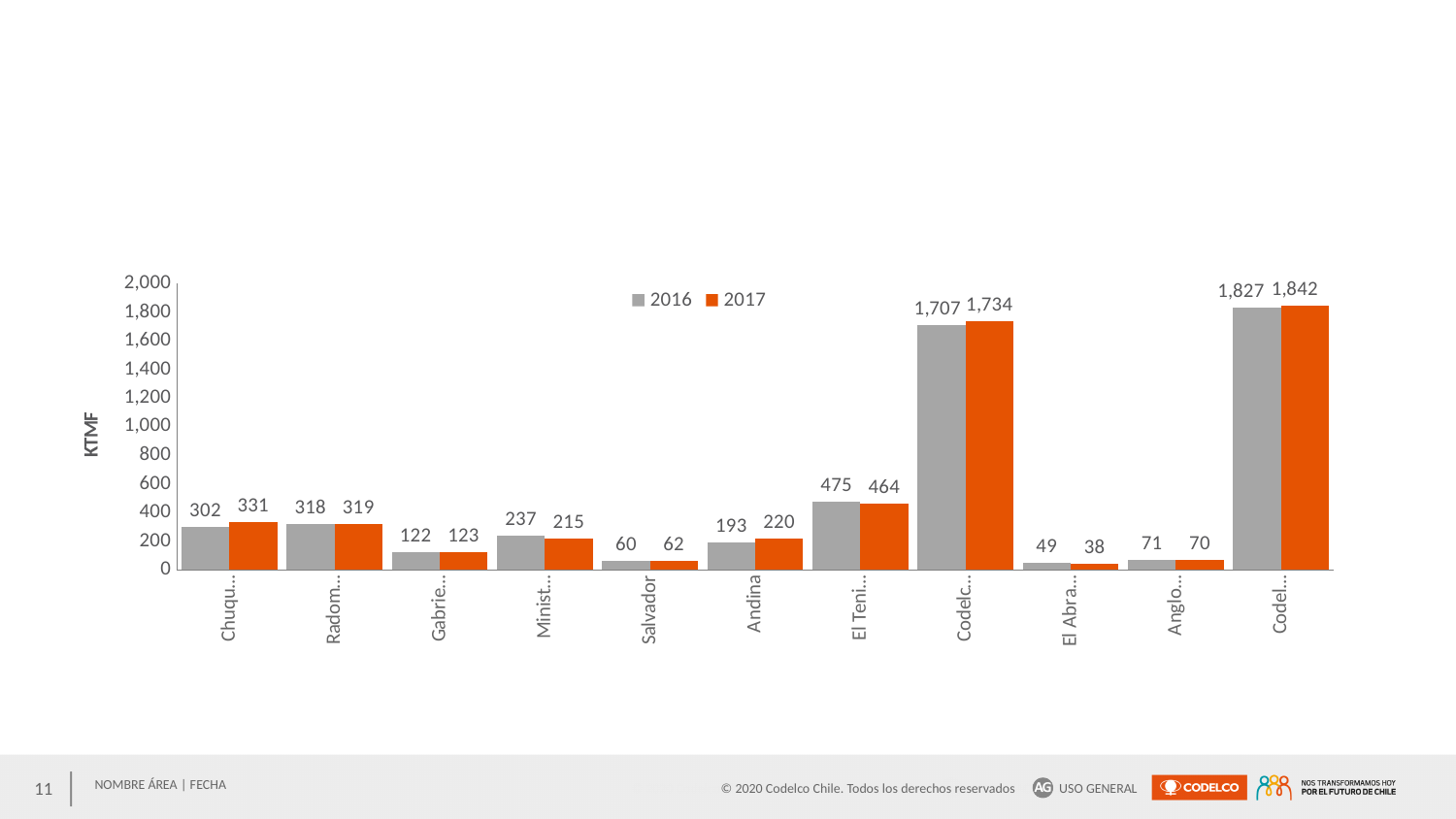
For Salvador, which year has the larger value, 2016 or 2017? 2017 What is the label on the vertical axis? KTMF What is the lowest 2016 value shown on the chart? 49 How many series does the legend list? 2 How many categories are shown on the x axis? 11 What is the 2016 value for Salvador? 60 What is the highest 2017 value shown on the chart? 1,842 What kind of chart is shown on the slide? bar chart What is the 2017 value for Andina? 220 What is the 2016 value for the category labelled "El Teni..."? 475 Is the 2016 value for Andina greater or less than 200? less By how much did the value for Andina increase from 2016 to 2017? 27